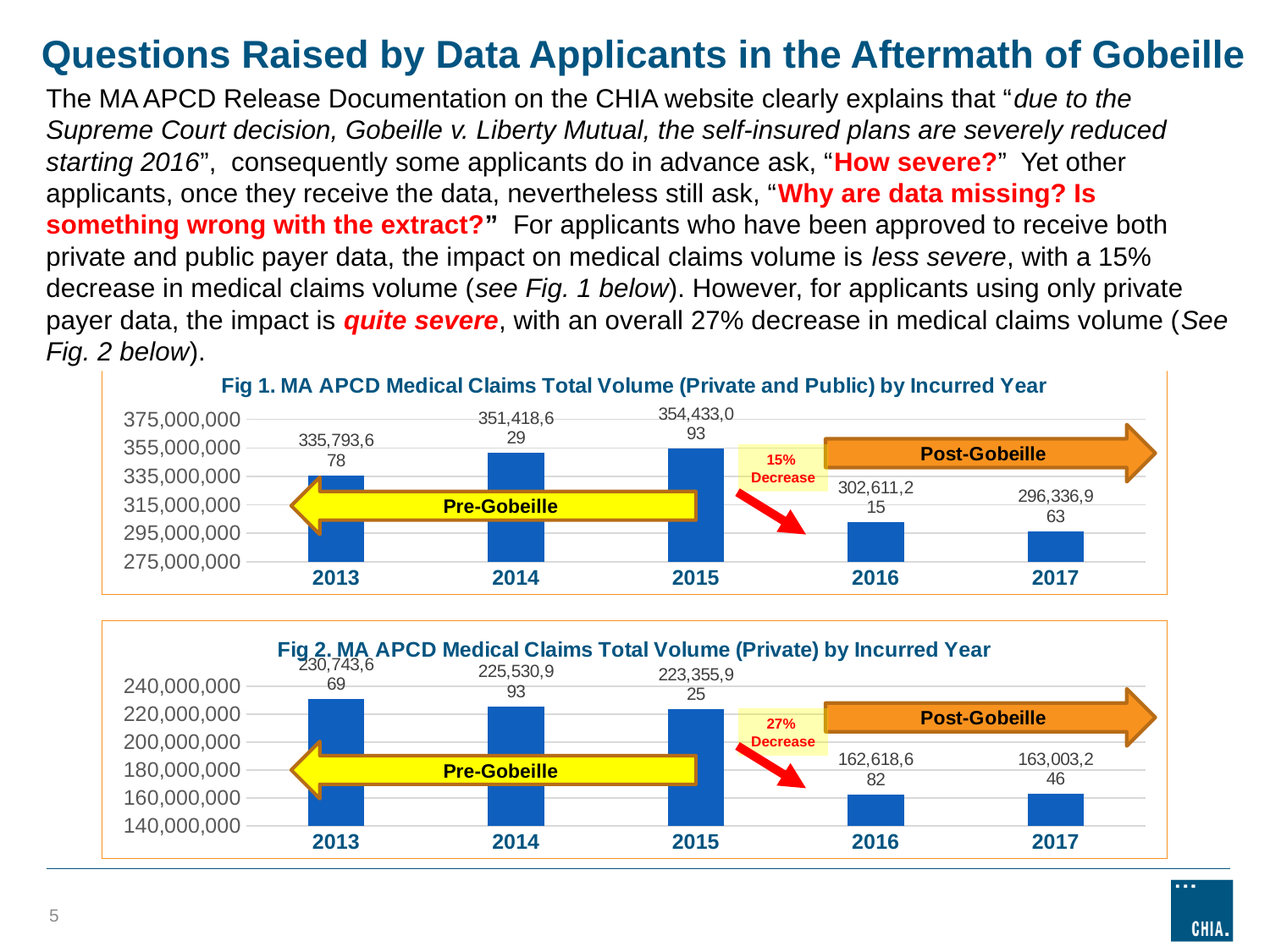
In Fig 1 (Private and Public), what is the difference in medical claims volume between 2015 and 2016? 51,821,878 In Fig 1 (Private and Public), how many incurred years are shown on the x axis? 5 In Fig 2 (Private), what is the difference in medical claims volume between 2013 and 2017? 67,740,423 In Fig 1 (Private and Public), what is the medical claims total volume for 2015? 354,433,093 In Fig 2 (Private), what is the medical claims total volume for 2016? 162,618,682 In Fig 1 (Private and Public), which incurred year has the lowest medical claims volume? 2017 What type of chart is Fig 2 (Private)? bar chart In Fig 2 (Private), which incurred year has the highest medical claims volume? 2013 In Fig 1 (Private and Public), what is the medical claims total volume for 2017? 296,336,963 In Fig 2 (Private), what is the medical claims total volume for 2013? 230,743,669 In Fig 1 (Private and Public), which incurred year has the highest medical claims volume? 2015 In Fig 2 (Private), is the medical claims volume for 2014 larger or smaller than for 2015? larger